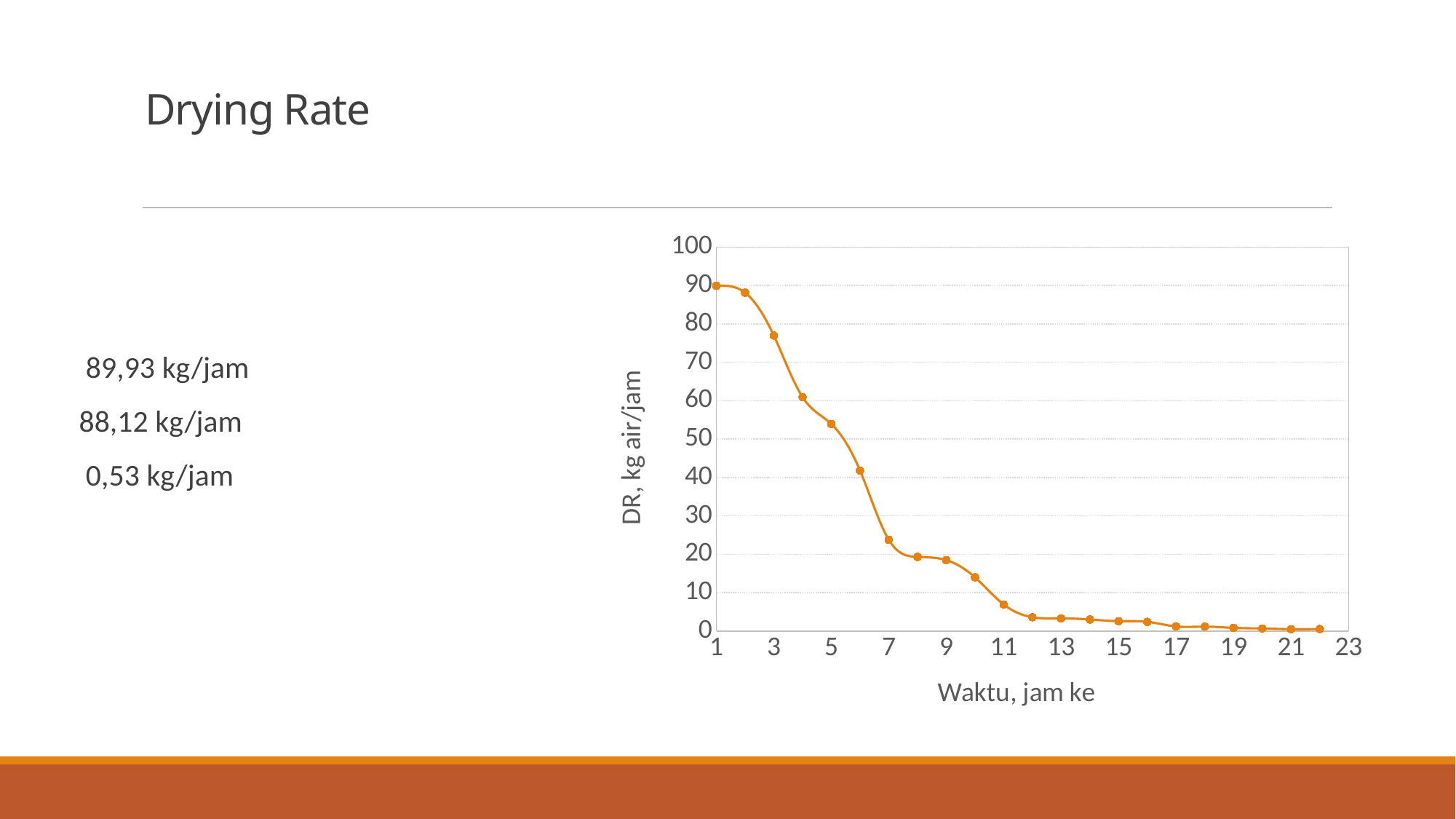
Which is larger, the value at hour 3 or the value at hour 6? hour 3 What kind of chart is shown on the slide? line chart Is the value at hour 6 greater or less than 50? less What is the title of the vertical axis? DR, kg air/jam How many data points are plotted on the line? 22 Is the value at hour 11 greater or less than 10? less What is the title of the horizontal axis? Waktu, jam ke Is the value at hour 5 greater or less than 50? greater Do the values rise or fall as time (Waktu, jam ke) increases along the x axis? fall